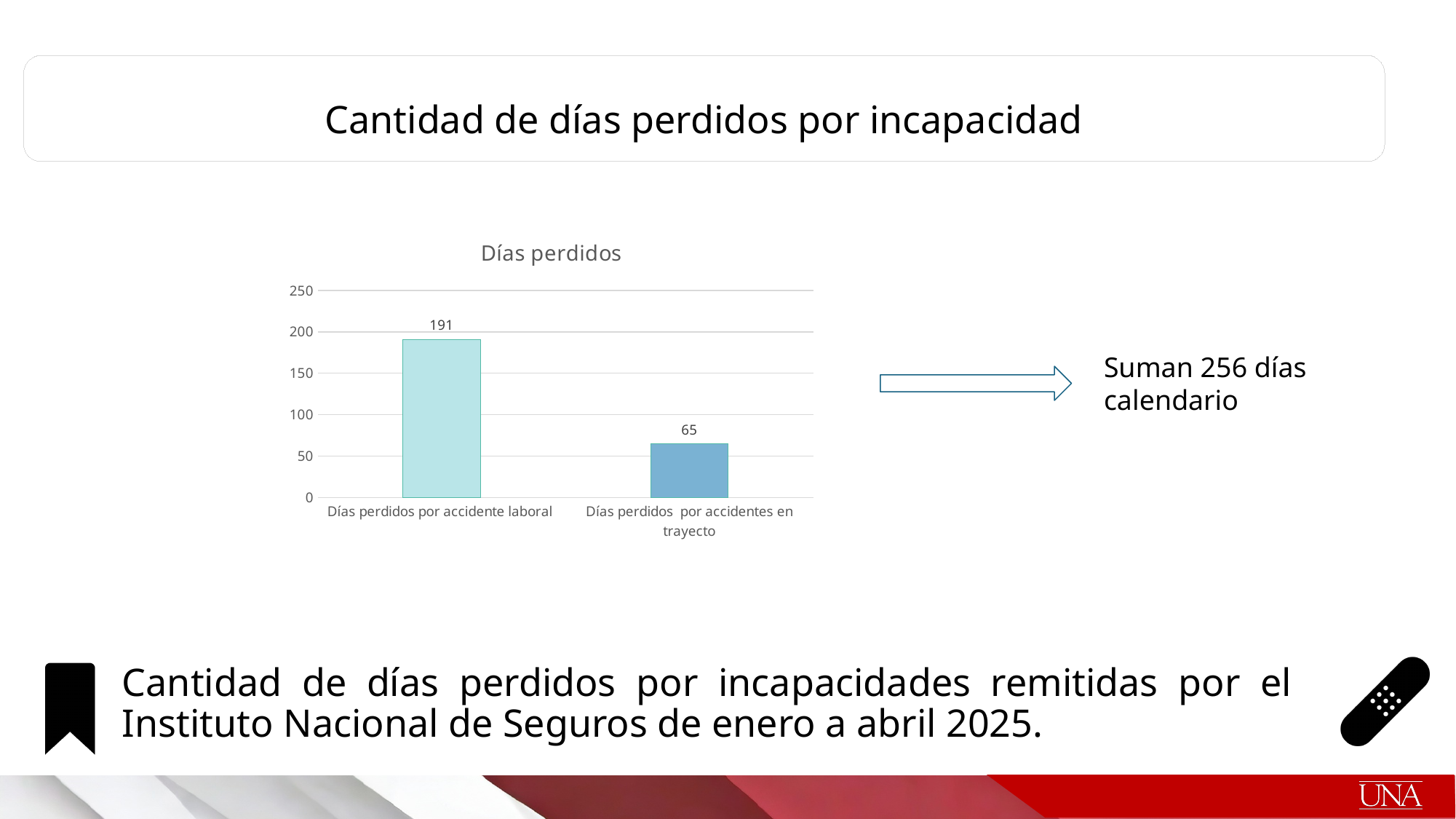
What kind of chart is shown on the slide? Bar chart What is the value for "Días perdidos por accidentes en trayecto"? 65 How many categories are shown in the chart? 2 What is the total of the two values plotted in the chart? 256 What is the difference between the values for "Días perdidos por accidente laboral" and "Días perdidos por accidentes en trayecto"? 126 Which category has the lowest value? Días perdidos por accidentes en trayecto What is the value for "Días perdidos por accidente laboral"? 191 What is the title of the chart? Días perdidos Is the value for "Días perdidos por accidente laboral" greater or less than 150? greater Which category has the highest value? Días perdidos por accidente laboral Which is larger: the value for "Días perdidos por accidente laboral" or for "Días perdidos por accidentes en trayecto"? Días perdidos por accidente laboral Is the value for "Días perdidos por accidentes en trayecto" greater or less than 100? less